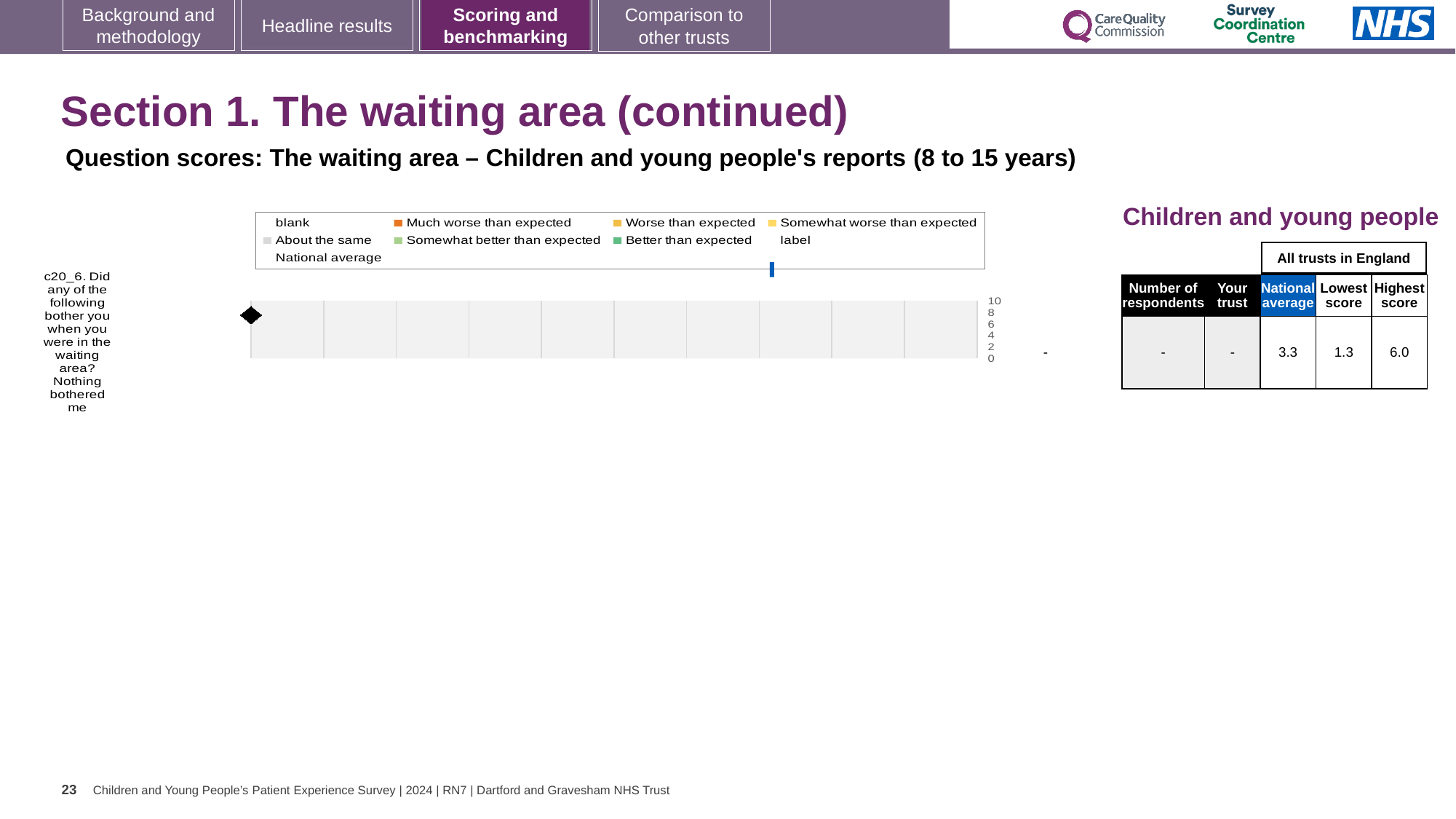
What is the difference between the highest score and the lowest score in the table for c20_6? 4.7 Which is larger in the table for c20_6: the national average or the lowest score? national average In the table next to the chart, what is the national average score for c20_6? 3.3 In the table next to the chart, what is the lowest score across all trusts in England for c20_6? 1.3 In the table next to the chart, what is the highest score across all trusts in England for c20_6? 6.0 Which question is plotted on the chart? c20_6. Did any of the following bother you when you were in the waiting area? Nothing bothered me What kind of chart is shown on the slide? bar chart What is the highest value shown on the chart's axis? 10 In the table next to the chart, what is shown as the 'Your trust' score for c20_6? - How many question categories are plotted on the chart? 1